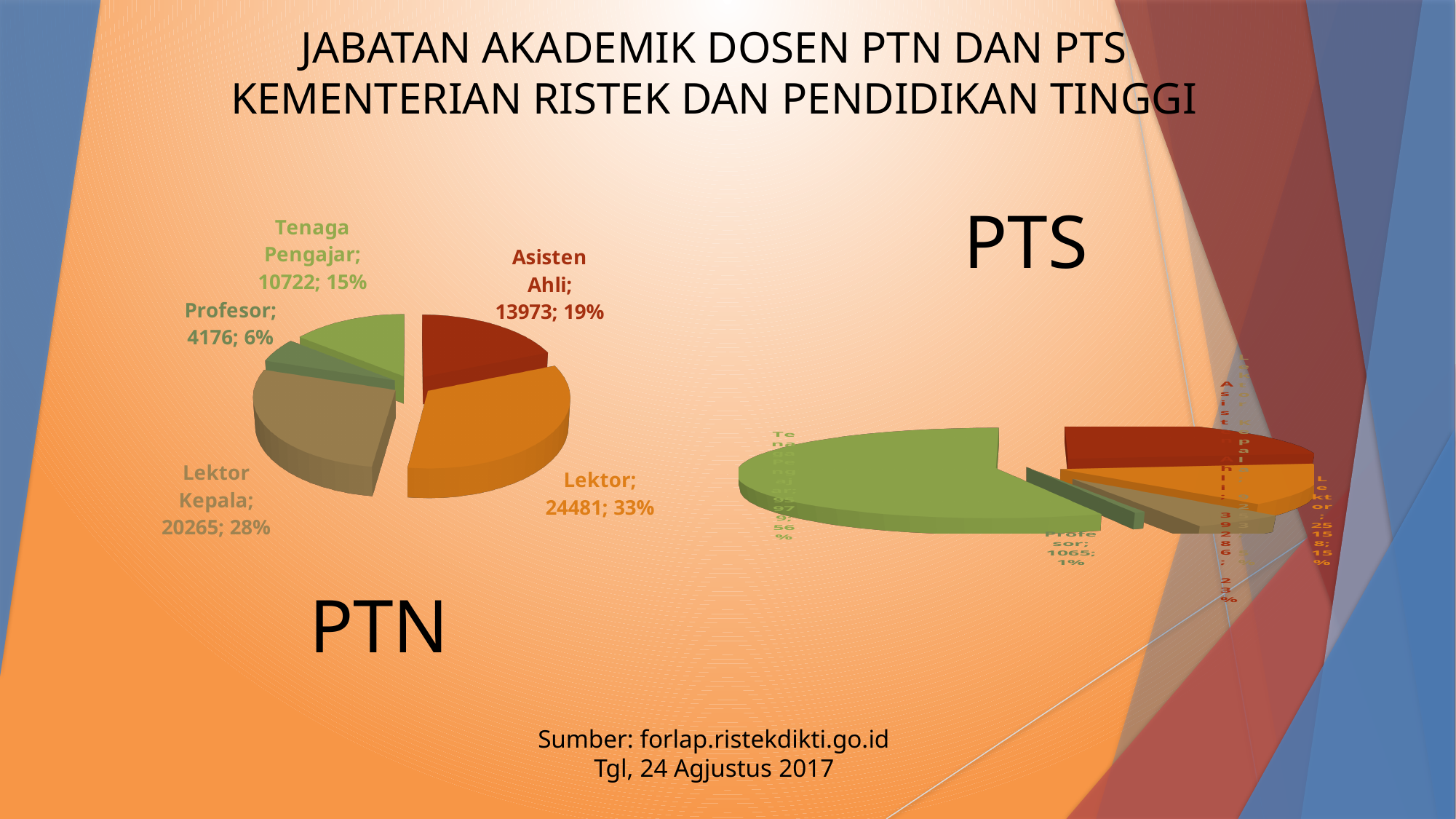
In the PTN pie chart, what is the value for Asisten Ahli? 13973 In the PTN pie chart, what is the difference between the values for Lektor and Lektor Kepala? 4216 What kind of chart is used for the PTN data? Pie chart In the PTN pie chart, what is the value for Profesor? 4176 In the PTS pie chart, what share of the pie does Profesor have? 1% In the PTN pie chart, which category has the smallest value? Profesor How many categories does the PTN pie chart show? 5 In the PTN pie chart, what is the value for Lektor? 24481 In the PTN pie chart, which is larger, Asisten Ahli or Tenaga Pengajar? Asisten Ahli In the PTN pie chart, which category has the largest value? Lektor In the PTN pie chart, what share of the pie does Lektor Kepala have? 28% In the PTN pie chart, what share of the pie does Tenaga Pengajar have? 15%